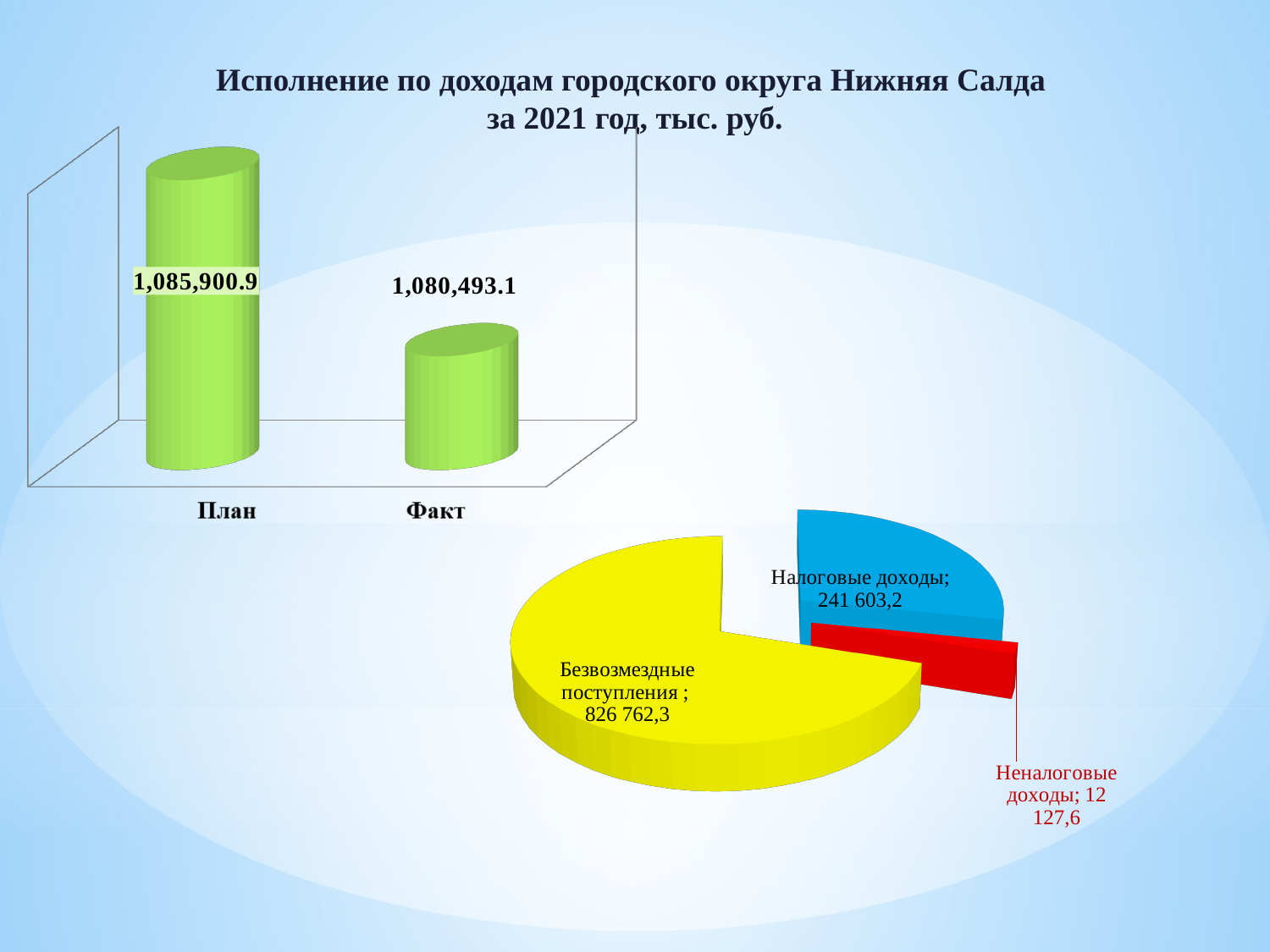
On the bar chart at the top left, what is the difference between План and Факт? 5,407.8 What is the title of the slide's charts? Исполнение по доходам городского округа Нижняя Салда за 2021 год, тыс. руб. On the pie chart, what is the difference between Безвозмездные поступления and Налоговые доходы? 585 159,1 On the pie chart, what is the value for Неналоговые доходы? 12 127,6 On the bar chart at the top left, what is the value for Факт? 1,080,493.1 What kind of chart is the chart at the top left of the slide? Bar chart On the pie chart, which category has the smallest value? Неналоговые доходы On the pie chart, what is the value for Налоговые доходы? 241 603,2 On the bar chart at the top left, what is the value for План? 1,085,900.9 On the bar chart at the top left, how many categories are shown? 2 On the bar chart at the top left, which is larger, План or Факт? План On the pie chart, which category has the largest value? Безвозмездные поступления